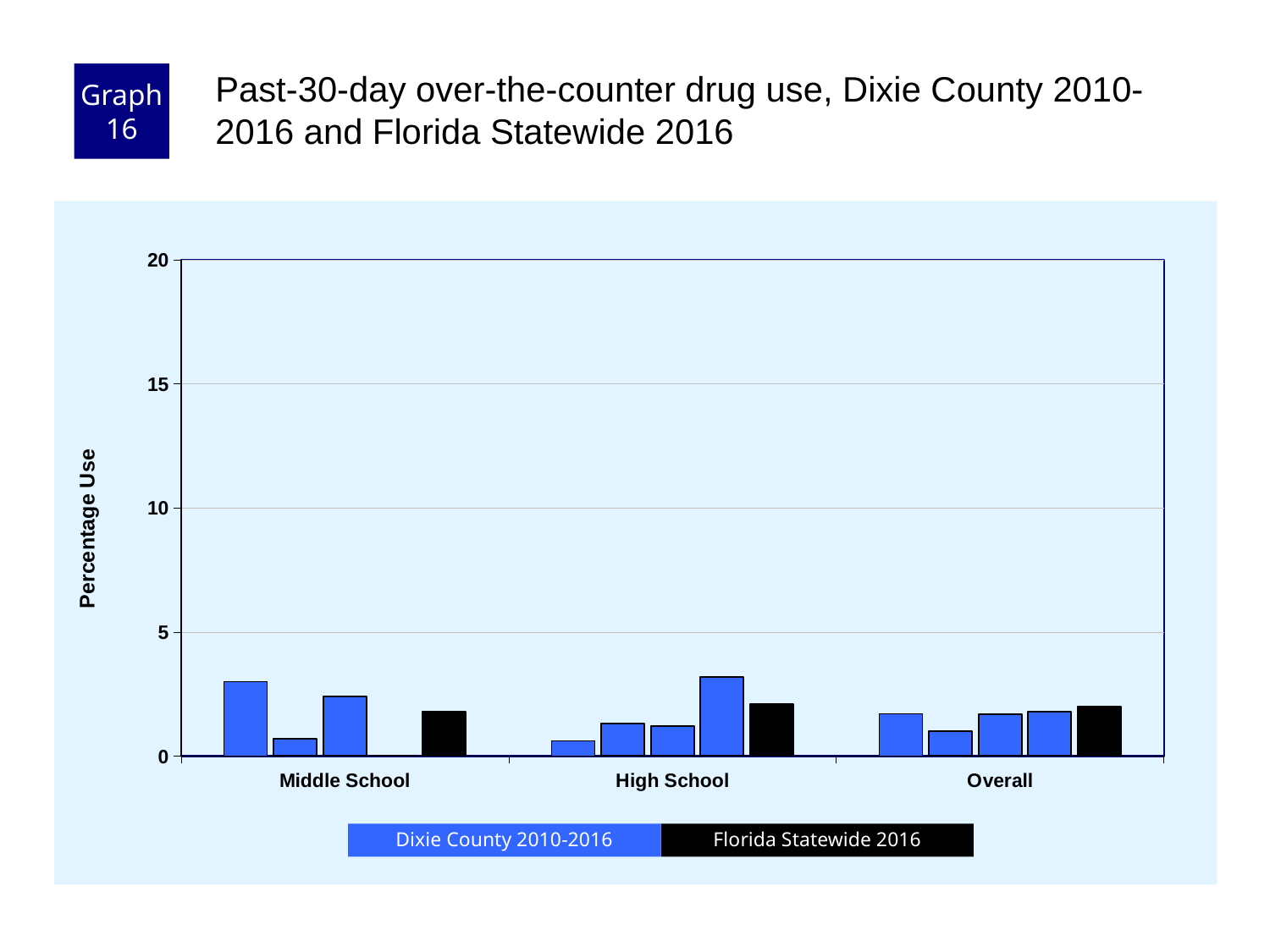
Is the tallest Dixie County 2010-2016 bar in the High School group greater or less than 5? less Is the Florida Statewide 2016 value for Overall greater or less than 5? less What is the title of the chart? Past-30-day over-the-counter drug use, Dixie County 2010-2016 and Florida Statewide 2016 What is the highest value shown on the y axis? 20 What kind of chart is shown on the slide? bar chart How many series does the legend list? 2 How many categories are shown on the x axis? 3 Is the tallest Dixie County 2010-2016 bar in the Middle School group greater or less than 5? less What is the label on the y axis? Percentage Use